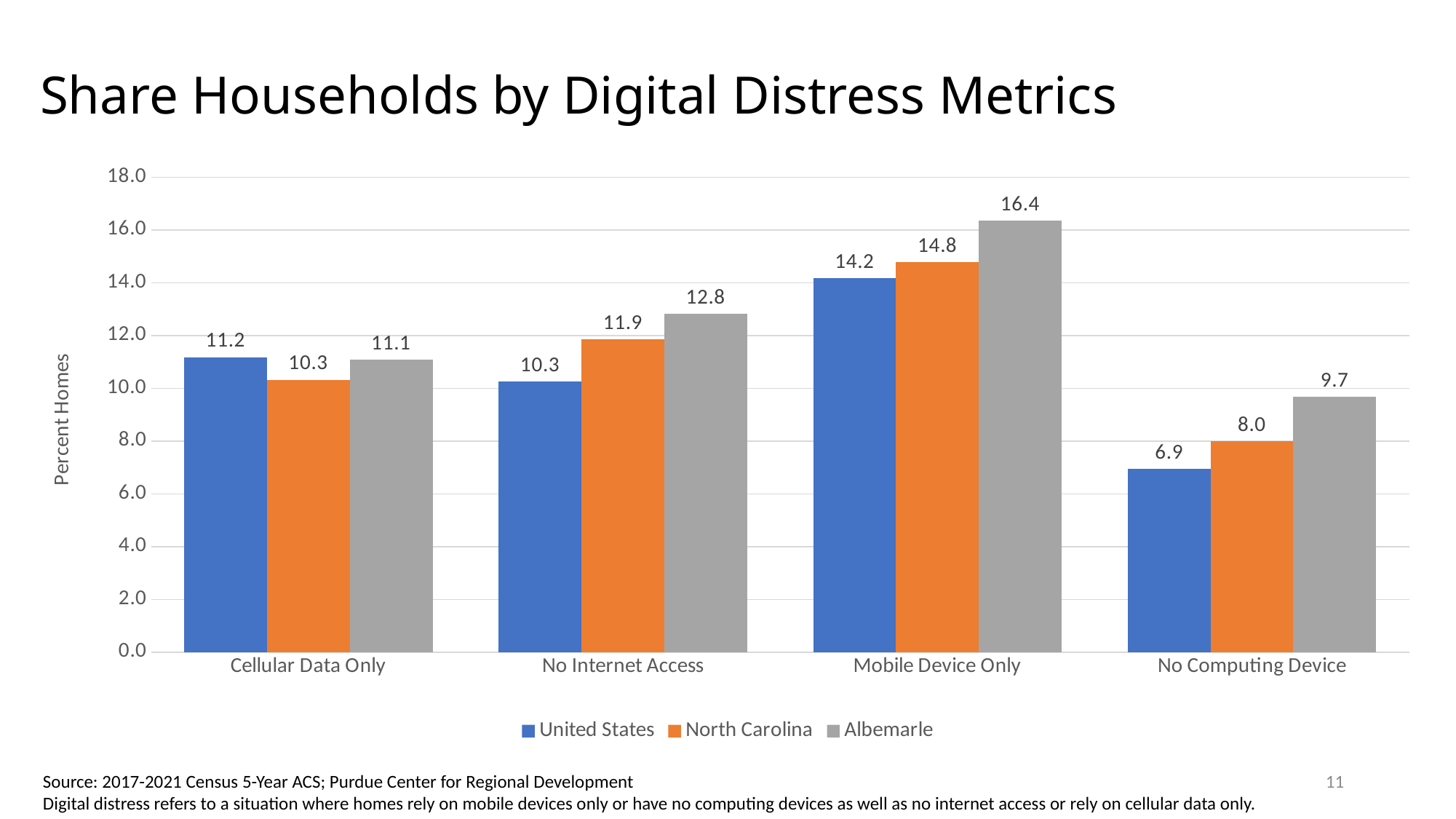
Which category has the lowest value for United States? No Computing Device Which category has the highest value for Albemarle? Mobile Device Only What is the difference between the Albemarle and United States values for No Internet Access? 2.5 What is the label of the y axis? Percent Homes Which is larger in the Cellular Data Only category, United States or North Carolina? United States What is the value for Albemarle in the Mobile Device Only category? 16.4 What is the value for North Carolina in the No Internet Access category? 11.9 What is the value for United States in the No Computing Device category? 6.9 How many series does the legend list? 3 How many categories are shown on the x axis? 4 What kind of chart is shown on the slide? Bar chart Is the value for Albemarle in the No Computing Device category greater or less than 10.0? less